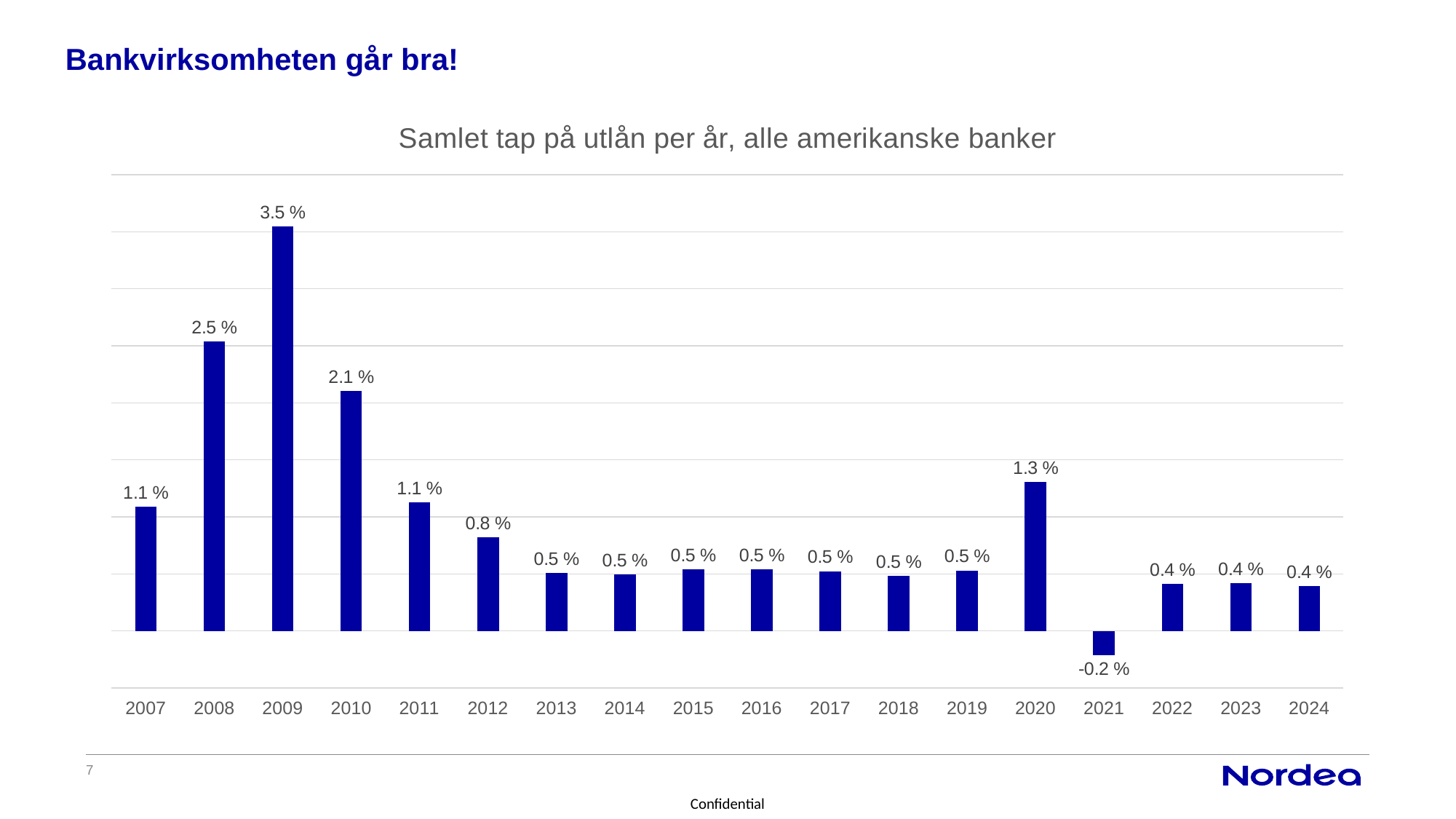
How many years are shown on the x axis? 18 Which is larger, the value for 2010 or the value for 2020? 2010 What is the title of the chart? Samlet tap på utlån per år, alle amerikanske banker What is the value for 2012? 0.8 % What kind of chart is this? Bar chart Do the values rise or fall from 2009 to 2013? Fall Which year has the lowest value? 2021 What is the difference between the values for 2009 and 2008? 1.0 % What is the value for 2009? 3.5 % Which year has the highest value? 2009 What is the value for 2020? 1.3 % What is the value for 2021? -0.2 %